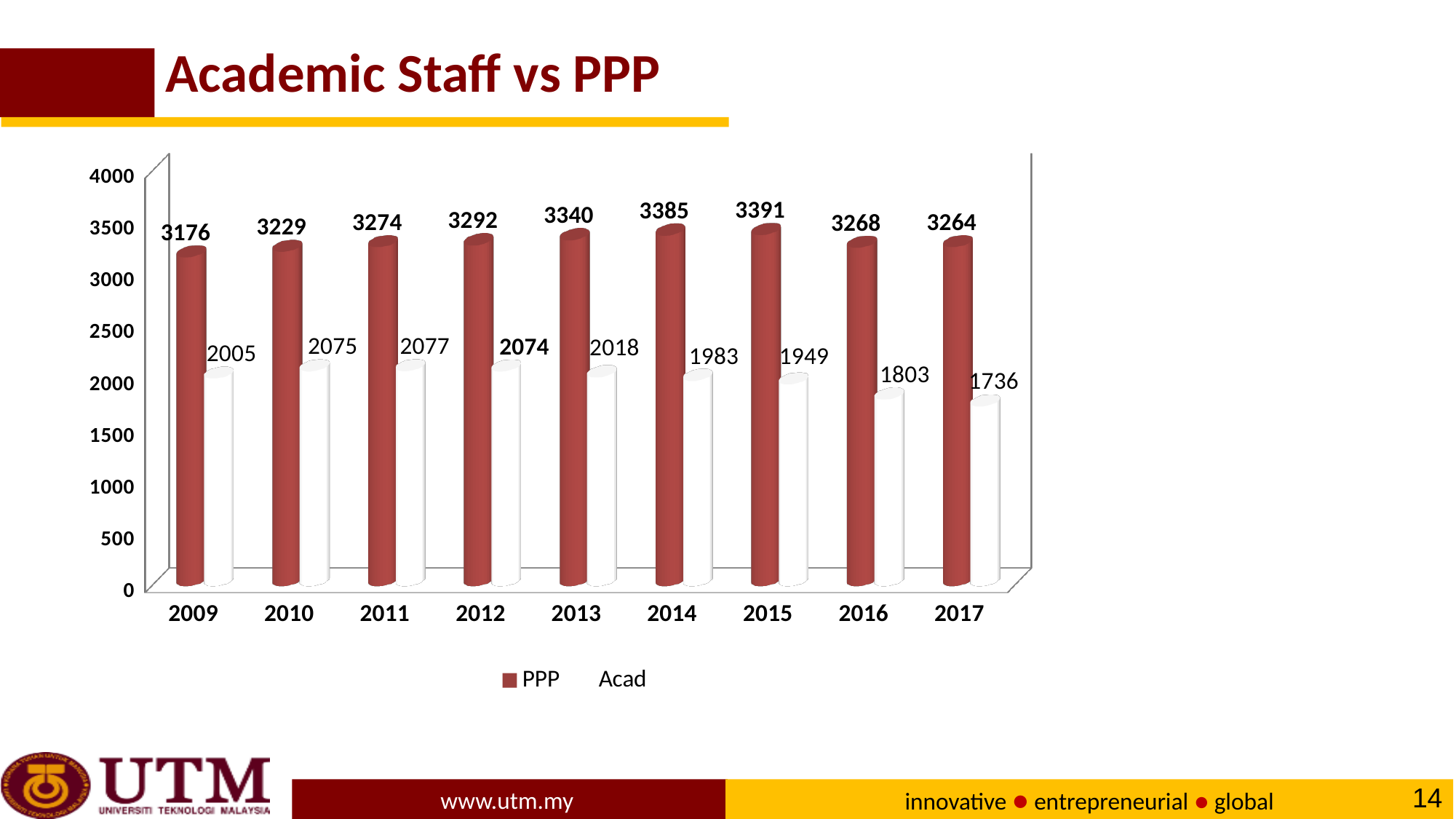
In which year is the PPP value highest? 2015 Is the Acad value for 2017 greater or less than 2000? less What is the difference between the PPP and Acad values in 2009? 1171 What is the title of the chart? Academic Staff vs PPP How many series does the legend list? 2 How many years are shown on the x axis? 9 Does the Acad value rise or fall from 2013 to 2017? fall What is the PPP value for 2013? 3340 What kind of chart is shown on the slide? bar chart What is the Acad value for 2016? 1803 In which year is the Acad value lowest? 2017 Which is larger, the Acad value for 2011 or the Acad value for 2014? 2011